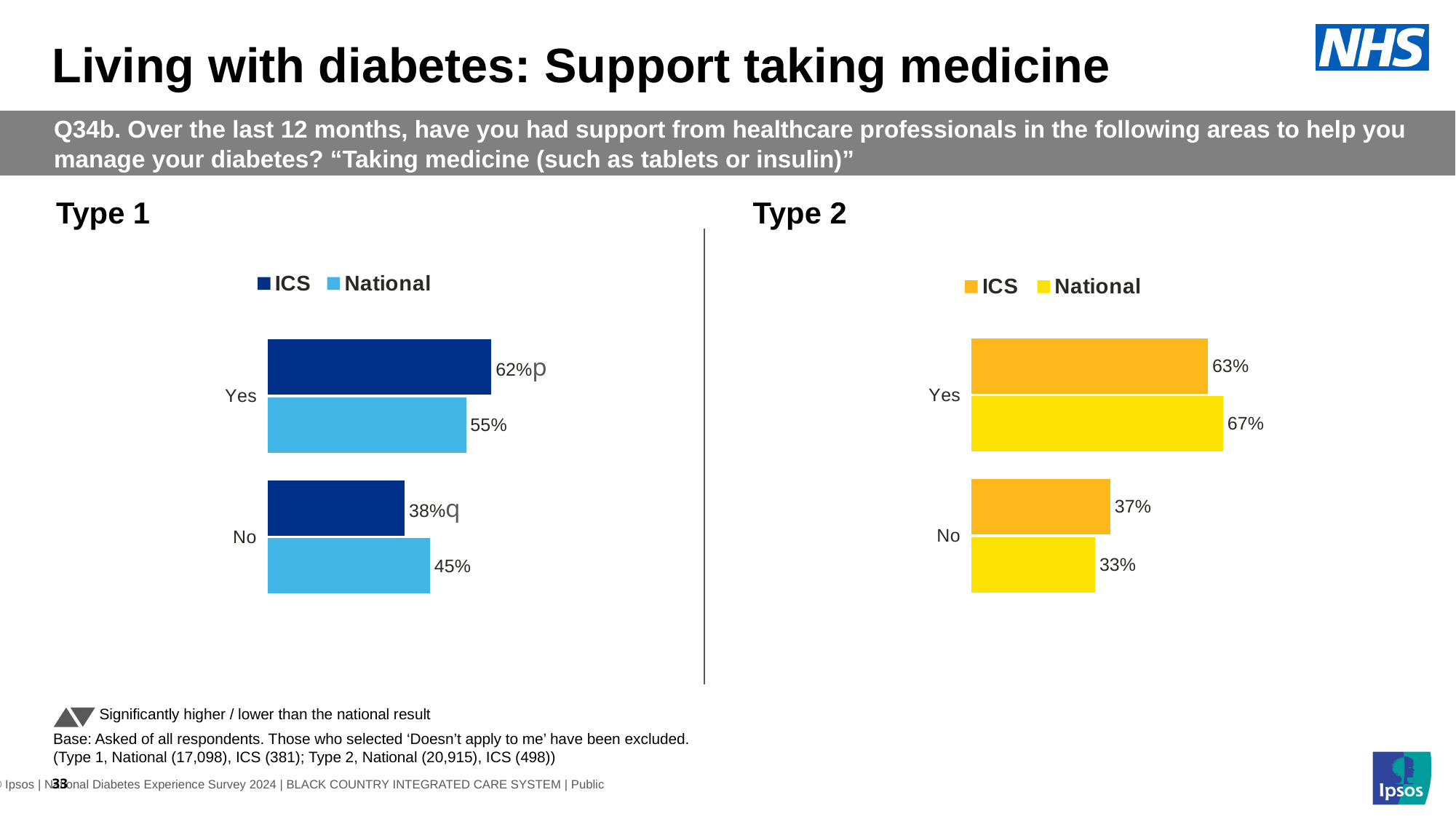
In the Type 1 chart, which series has the highest value for Yes? ICS In the Type 1 chart, what is the National value for No? 45% How many categories are shown in the Type 1 chart? 2 In the Type 1 chart, what is the difference between the ICS and National values for Yes? 7 percentage points In the Type 1 chart, which is larger for No, ICS or National? National How many series does the legend of the Type 2 chart list? 2 In the Type 2 chart, which is larger for Yes, ICS or National? National In the Type 1 chart, what is the ICS value for Yes? 62% What kind of chart is the Type 2 chart? Bar chart In the Type 2 chart, what is the ICS value for No? 37% In the Type 2 chart, what is the difference between the National and ICS values for No? 4 percentage points In the Type 2 chart, what is the National value for Yes? 67%